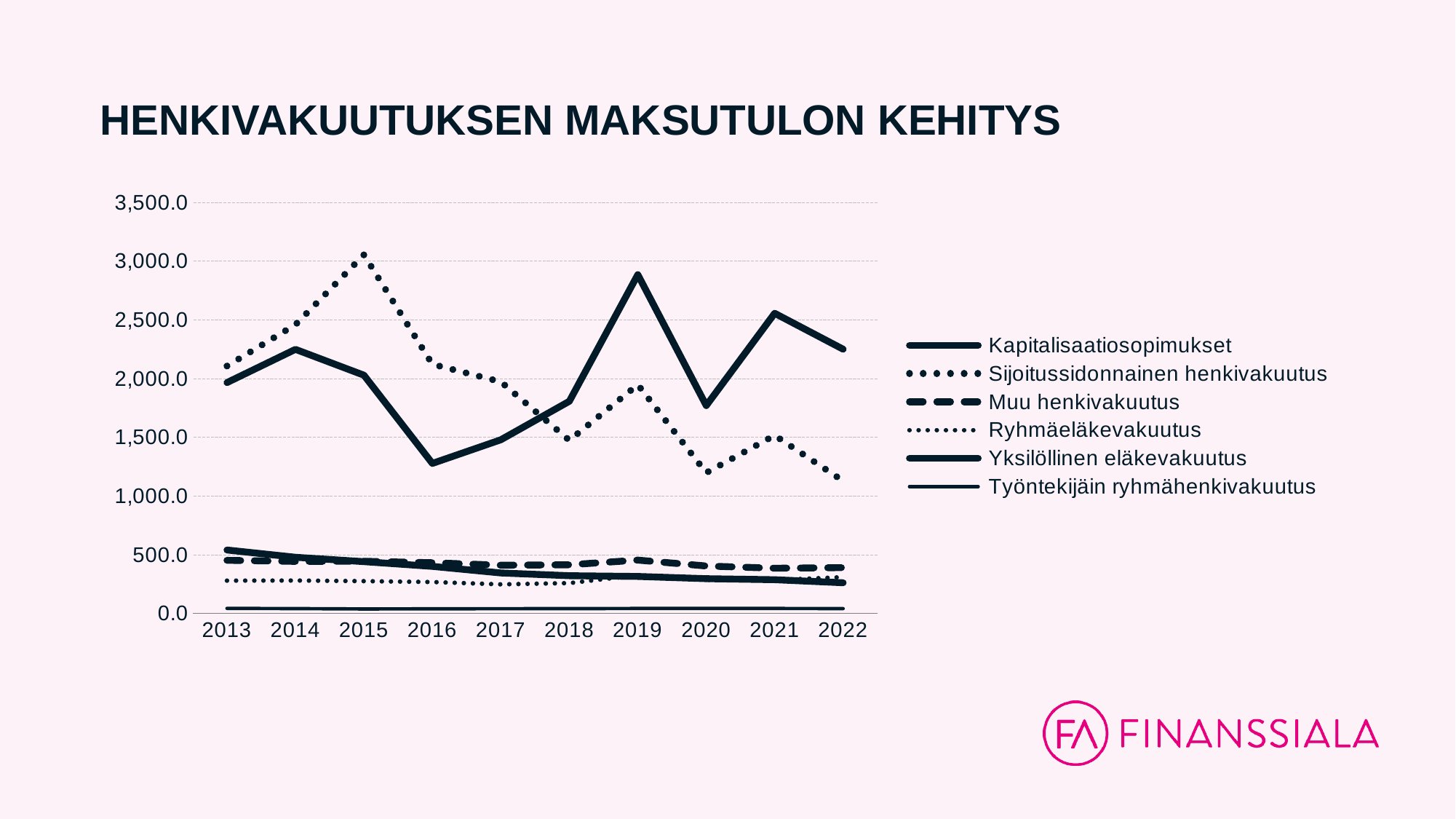
Is the value for Kapitalisaatiosopimukset in 2016 greater or less than 1,500.0? less Is the value for Kapitalisaatiosopimukset in 2019 greater or less than 2,500.0? greater In which year does Kapitalisaatiosopimukset reach its highest value? 2019 In which year does Sijoitussidonnainen henkivakuutus reach its highest value? 2015 What kind of chart is shown on the slide? line chart How many series does the legend list? 6 Is the value for Ryhmäeläkevakuutus in 2013 greater or less than 500.0? less How many years are shown on the x axis? 10 What is the title of the chart? HENKIVAKUUTUKSEN MAKSUTULON KEHITYS Which series has the lowest values across all years? Työntekijäin ryhmähenkivakuutus In 2022, which is higher, Kapitalisaatiosopimukset or Sijoitussidonnainen henkivakuutus? Kapitalisaatiosopimukset